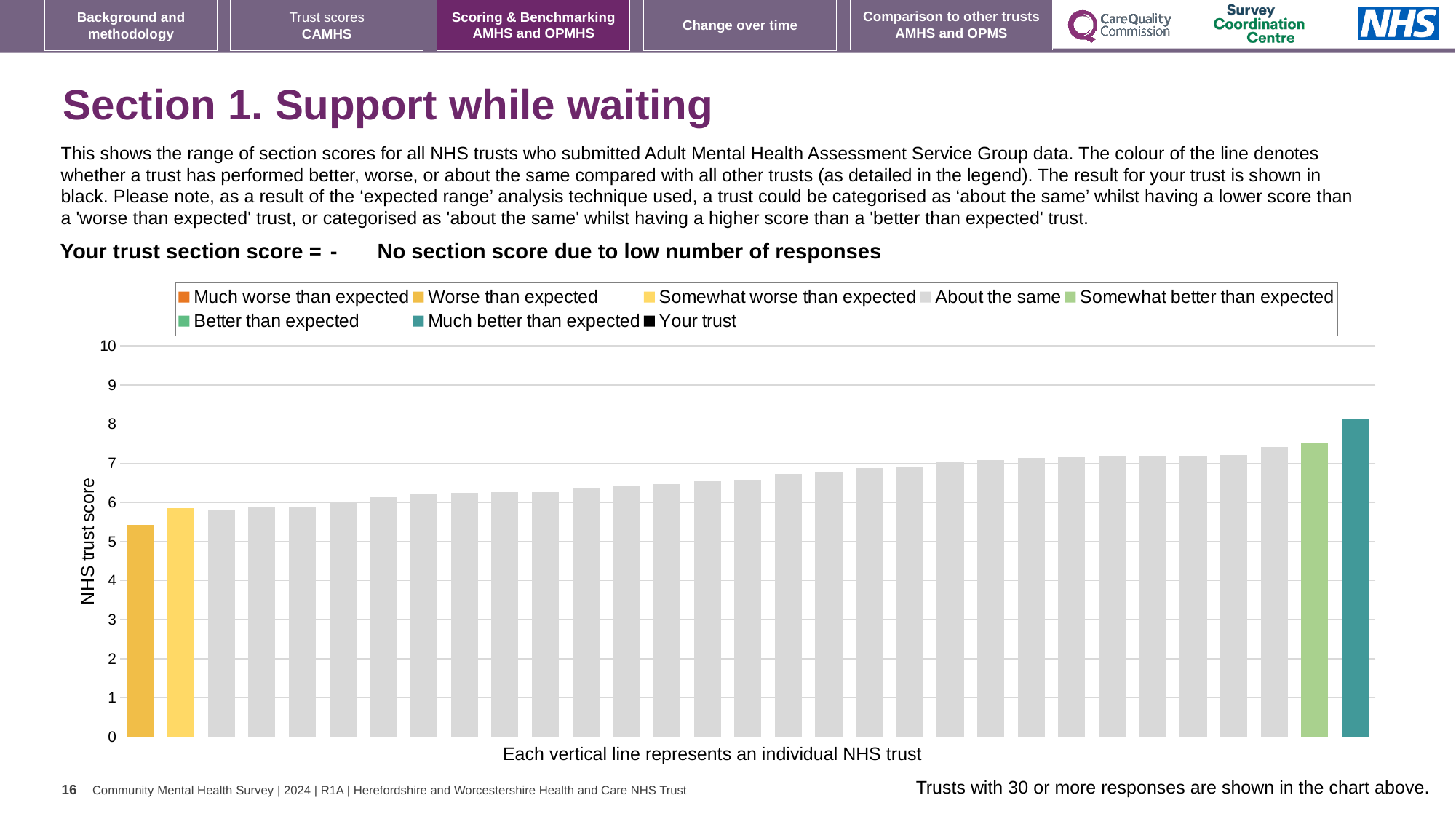
What is the label on the vertical axis of the chart? NHS trust score Is the value of the tallest bar (the rightmost, teal bar) greater or less than 8? greater What kind of chart is shown on the slide? bar chart Do the bar values rise or fall from left to right along the x axis? rise Which legend category does the shortest bar belong to? Worse than expected Which is larger: the leftmost bar or the rightmost bar? the rightmost bar How many entries does the chart legend list? 8 Is the value of the light green bar (second from the right) greater or less than 7? greater Is the value of the leftmost bar greater or less than 6? less Which legend category does the tallest bar belong to? Much better than expected What is the highest value shown on the vertical axis? 10